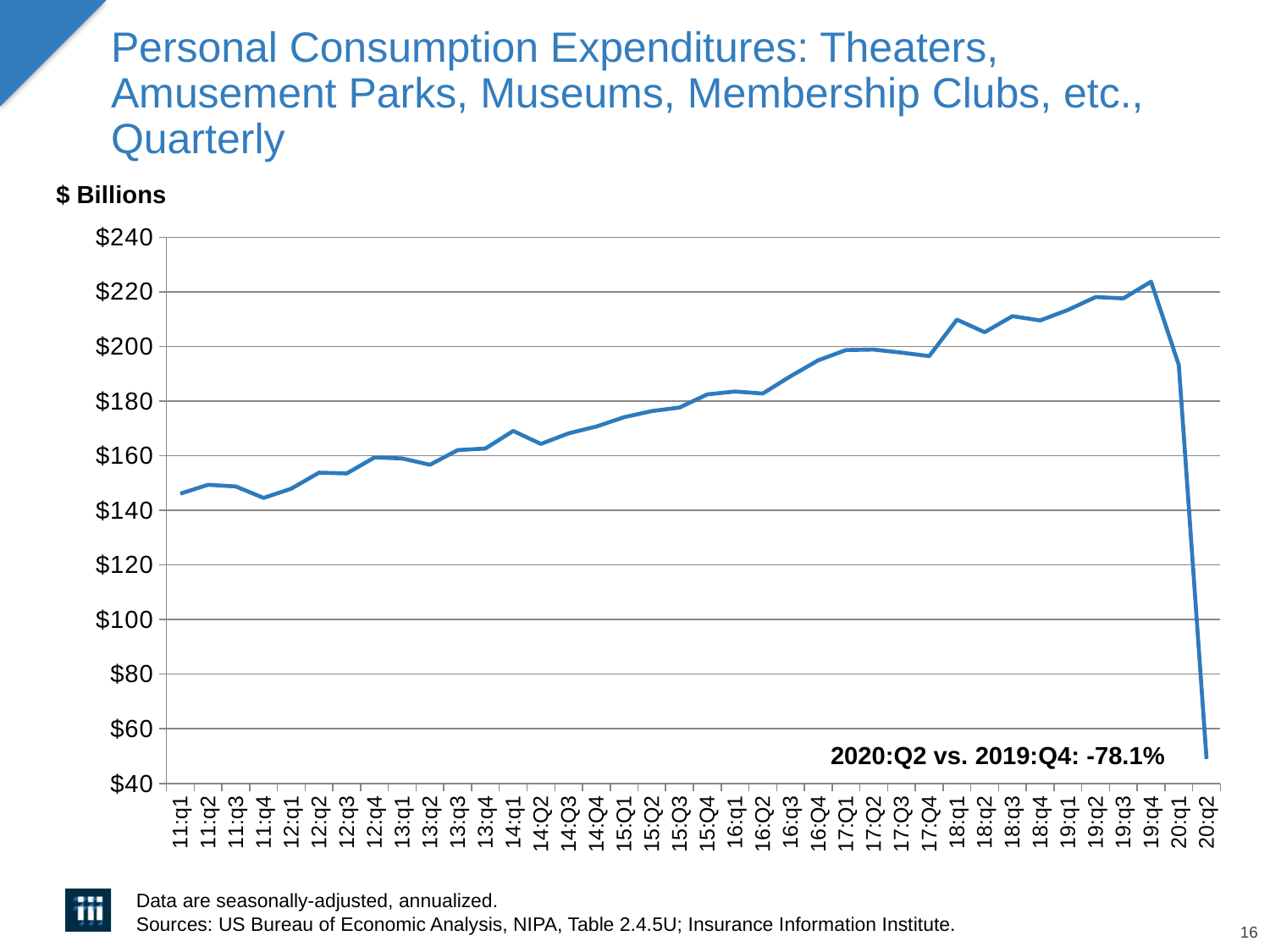
What kind of chart is shown on the slide? line chart Which quarter has the highest value on the chart? 19:q4 What percentage change from 2019:Q4 to 2020:Q2 is annotated on the chart? -78.1% Is the value for 14:q1 greater or less than $160? greater Is the value for 19:q4 greater or less than $220? greater Which quarter has the lowest value on the chart? 20:q2 Is the value for 11:q1 greater or less than $140? greater Do the values generally rise or fall from 11:q1 to 19:q4? rise How many quarterly data points are plotted on the chart? 38 Which quarter has the larger value, 20:q1 or 20:q2? 20:q1